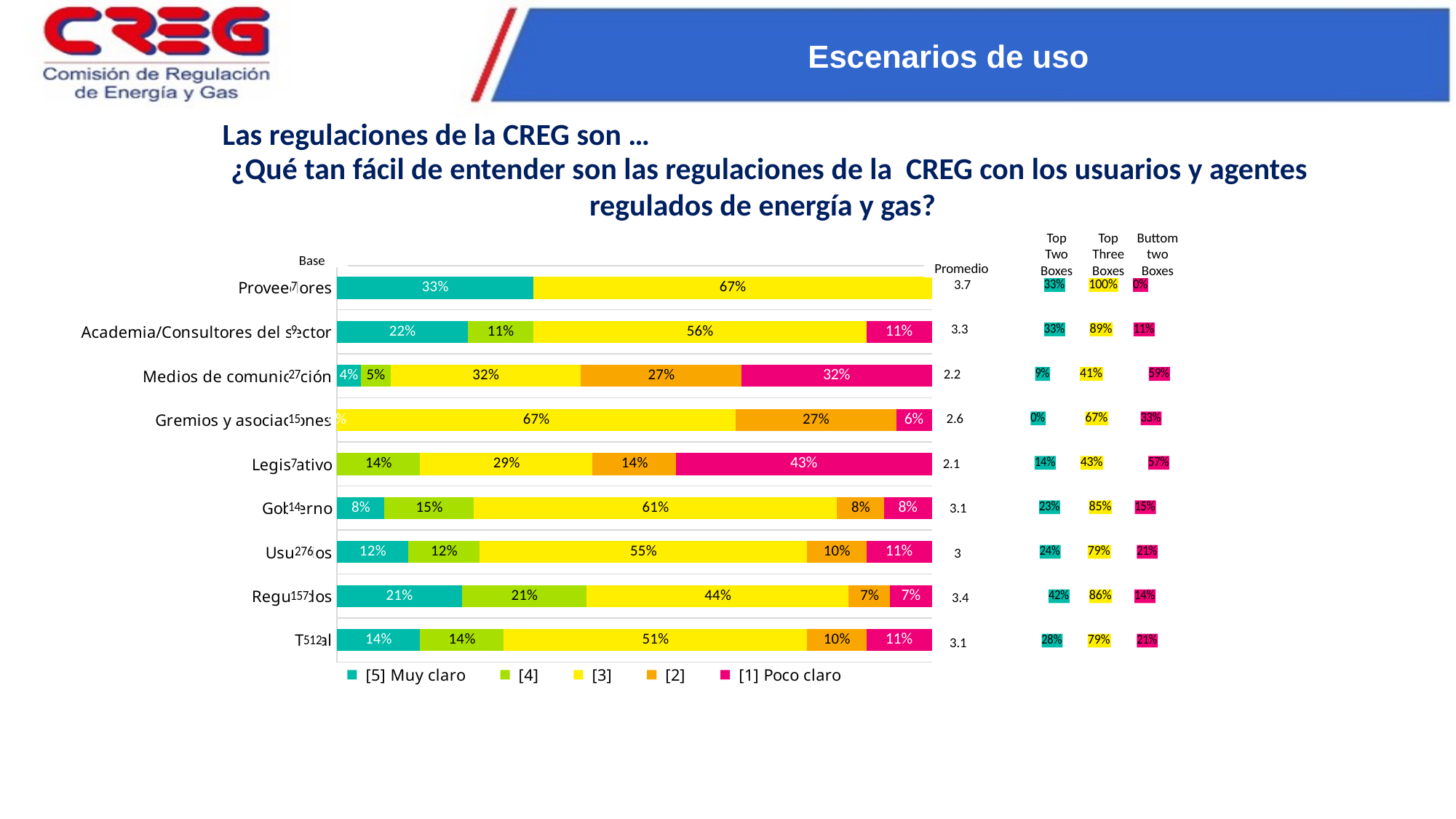
What is the value of the [1] Poco claro segment for Legislativo? 43% Which has a larger [1] Poco claro value, Medios de comunicación or Legislativo? Legislativo Which category has the highest [5] Muy claro value? Proveedores What is the first entry in the chart legend? [5] Muy claro What is the value of the [3] segment for Proveedores? 67% How many categories (rows) are plotted in the chart? 9 For Academia/Consultores del sector, what is the difference between the [3] segment and the [5] Muy claro segment? 34 percentage points What is the value of the [2] segment for Usuarios? 10% How many series does the chart legend list? 5 What is the value of the [3] segment for Gobierno? 61% What is the value of the [5] Muy claro segment for Regulados? 21% What kind of chart is shown on the slide? Stacked bar chart